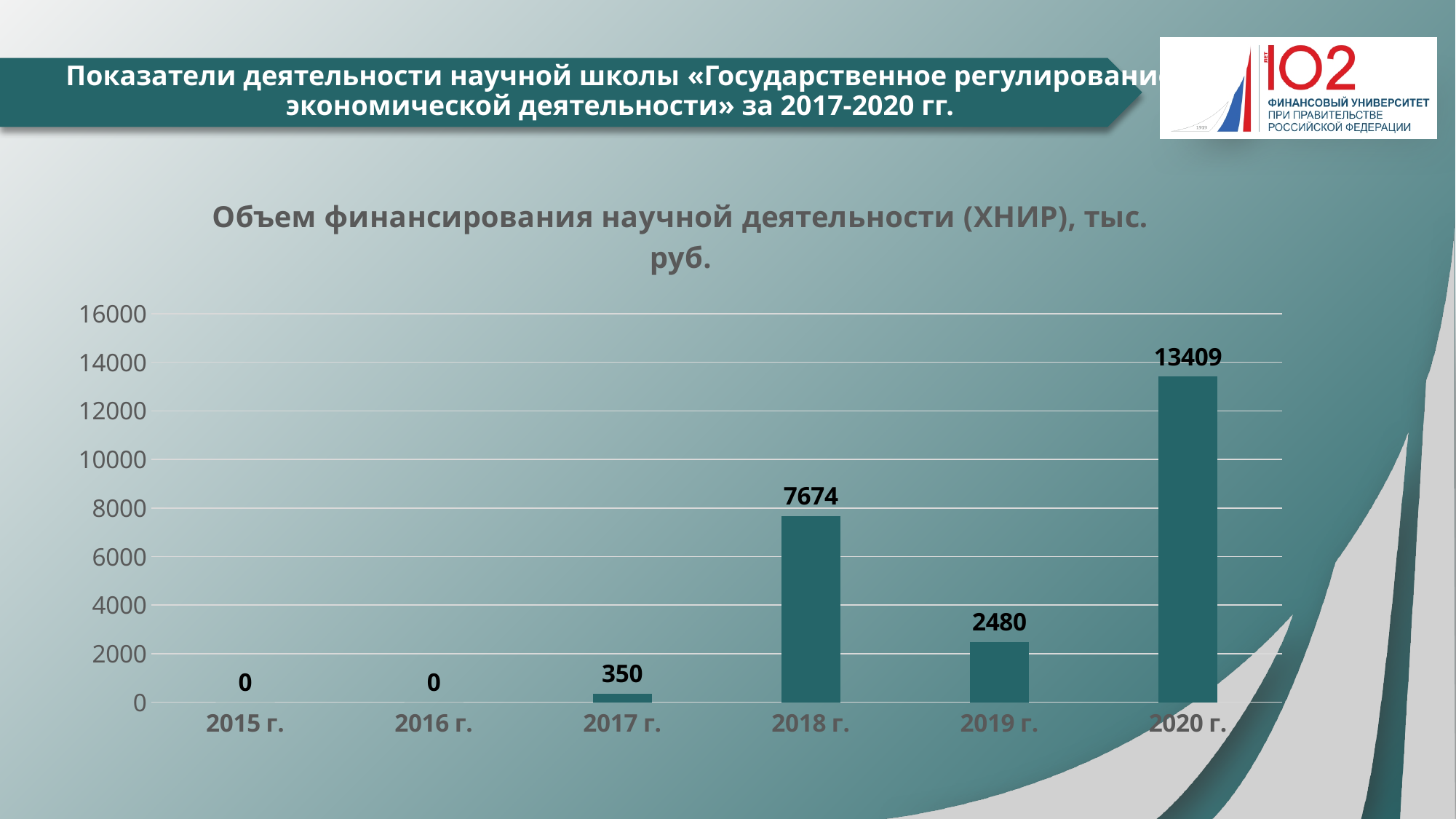
What is the value for 2017 г.? 350 Which year has the highest value? 2020 г. What is the value for 2019 г.? 2480 What is the difference between the values for 2020 г. and 2018 г.? 5735 What is the difference between the values for 2018 г. and 2019 г.? 5194 What is the title of the chart? Объем финансирования научной деятельности (ХНИР), тыс. руб. Is the value for 2020 г. greater or less than 12000? greater What kind of chart is this? bar chart What is the value for 2018 г.? 7674 What is the value for 2020 г.? 13409 Which is larger, the value for 2018 г. or the value for 2019 г.? 2018 г. How many years are shown on the x axis? 6